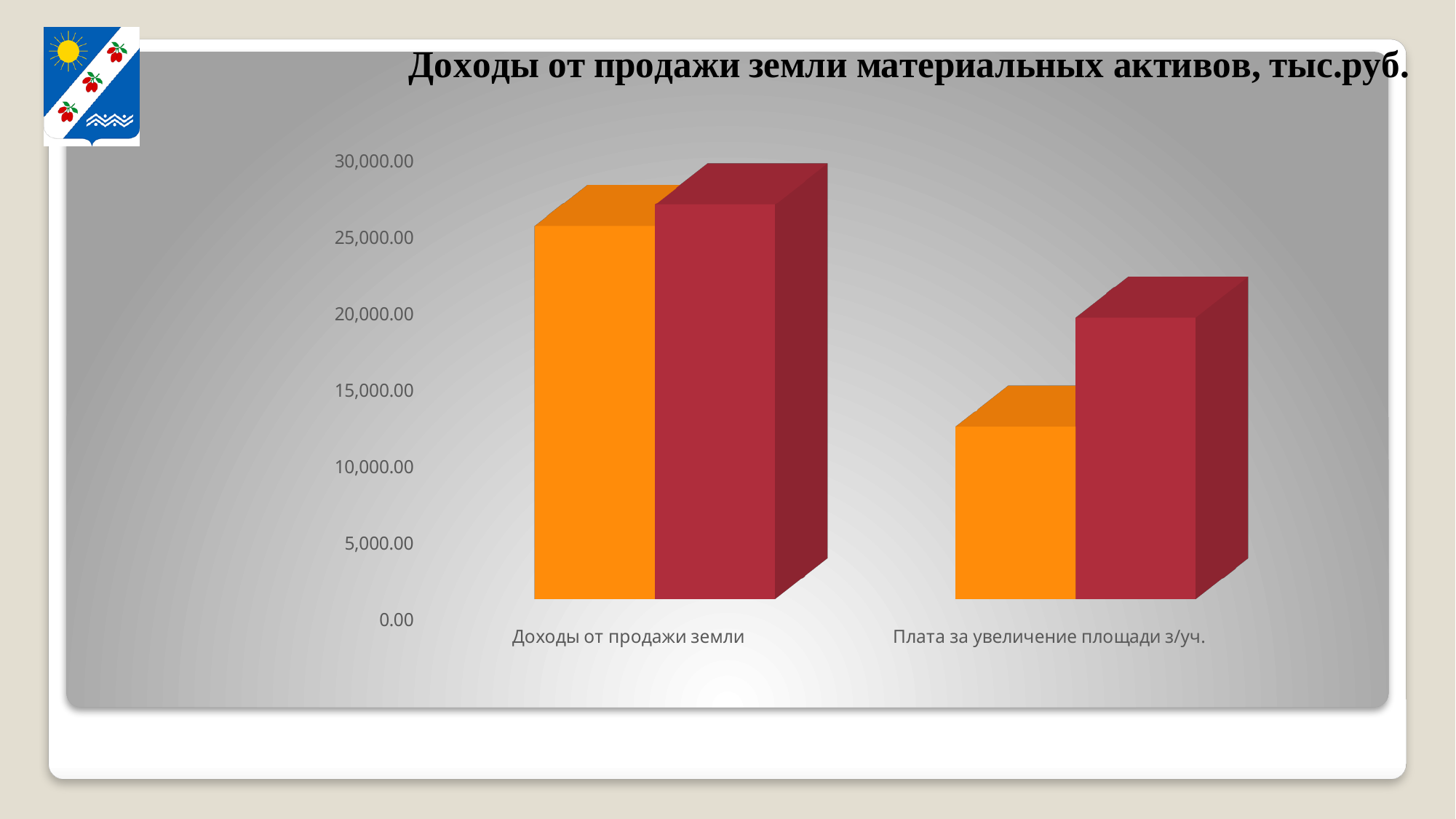
Which category has the shortest bar in the chart? Плата за увеличение площади з/уч. For 'Плата за увеличение площади з/уч.', which bar is larger, the orange one or the red one? The red one What kind of chart is shown on the slide? Bar chart How many categories are shown on the x axis of the chart? 2 Is the value of the red bar for 'Плата за увеличение площади з/уч.' greater or less than 15,000.00? greater What is the title of the chart? Доходы от продажи земли материальных активов, тыс.руб. Do the values rise or fall from 'Доходы от продажи земли' to 'Плата за увеличение площади з/уч.'? Fall Is the value of the orange bar for 'Плата за увеличение площади з/уч.' greater or less than 15,000.00? less Which category has the tallest bar in the chart? Доходы от продажи земли How many bars are plotted for each category in the chart? 2 Is the value of the orange bar for 'Доходы от продажи земли' greater or less than 20,000.00? greater